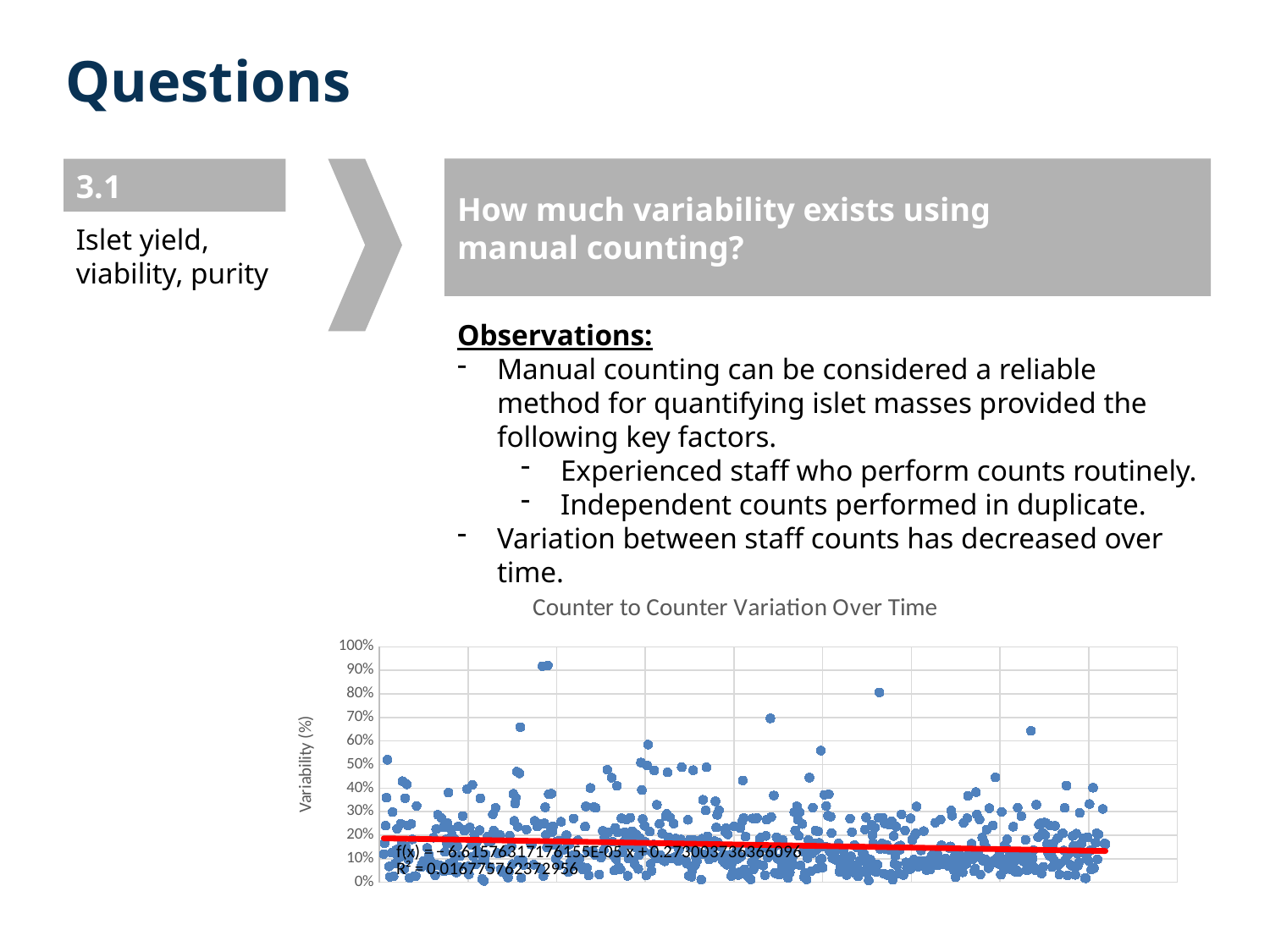
Is the highest plotted variability value greater or less than 80%? greater What is the label of the vertical axis of the chart? Variability (%) Is the lowest plotted variability value greater or less than 10%? less What is the title of the chart on the slide? Counter to Counter Variation Over Time What R² value is printed on the chart for the trendline? R² = 0.016775762372956 What is the highest tick value shown on the vertical axis of the chart? 100% What kind of chart is shown on the slide? Scatter chart According to the red trendline, do the variability values rise or fall over time along the x axis? Fall Is the slope of the trendline equation printed on the chart positive or negative? Negative What is the intercept term in the trendline equation printed on the chart? 0.273003736366096